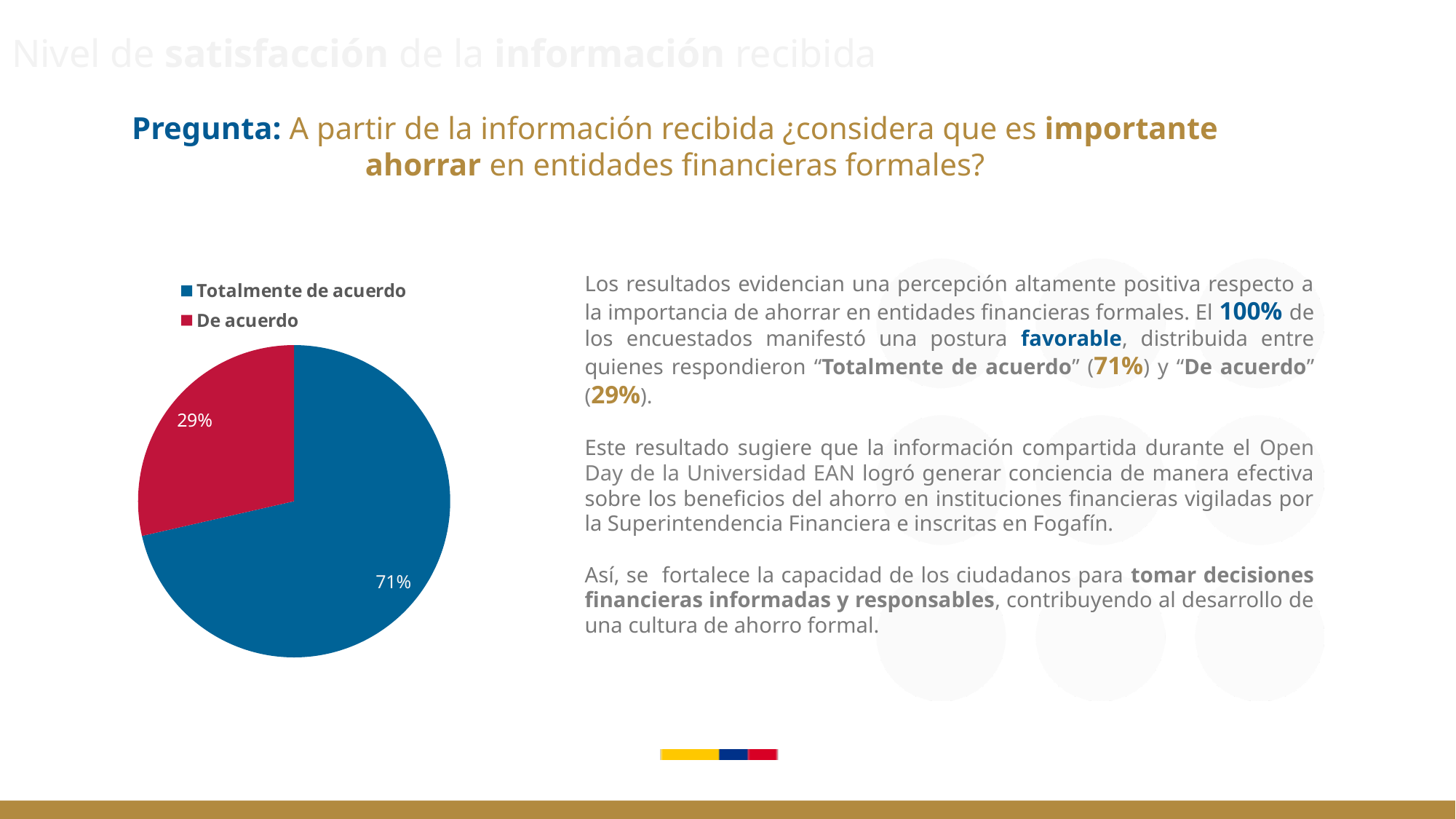
What colour is the slice for "Totalmente de acuerdo"? blue What is the difference in percentage points between "Totalmente de acuerdo" and "De acuerdo"? 42 What kind of chart is shown on the slide? pie chart What colour is the slice for "De acuerdo"? red Which category has the smallest slice of the pie? De acuerdo What share of the pie does "Totalmente de acuerdo" represent? 71% How many entries does the legend list? 2 How many categories does the pie chart show? 2 What share of the pie does "De acuerdo" represent? 29% What is the total of the two slices shown in the pie chart? 100% Which category has the largest slice of the pie? Totalmente de acuerdo Which is larger: the slice for "Totalmente de acuerdo" or the slice for "De acuerdo"? Totalmente de acuerdo